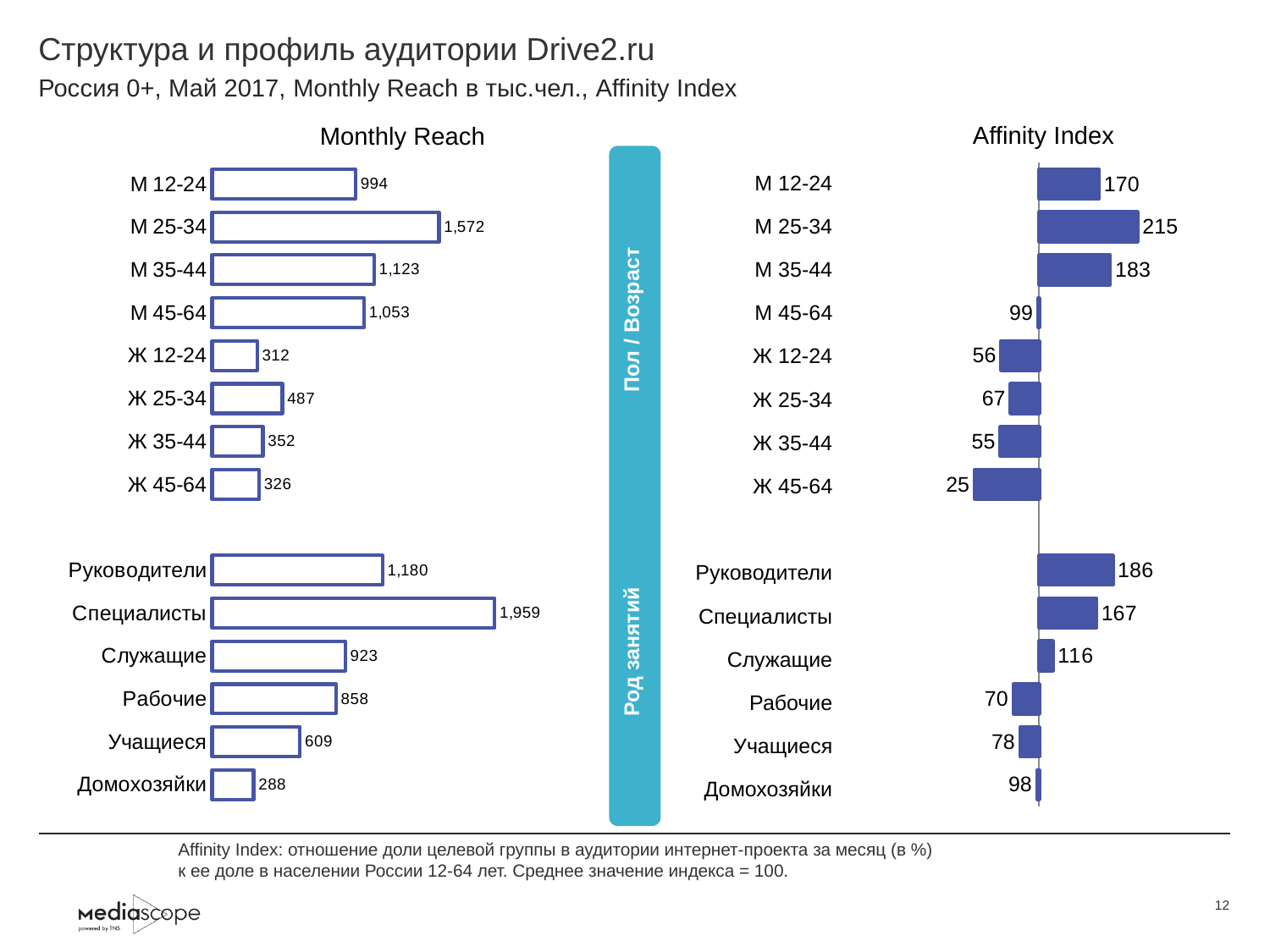
In the Affinity Index chart, what is the value for Ж 45-64? 25 In the Monthly Reach chart, what is the value for М 25-34? 1,572 In the Affinity Index chart, what is the difference between М 35-44 and М 45-64? 84 How many categories are shown in the Monthly Reach chart? 14 What kind of chart is the Affinity Index chart? Bar chart In the Affinity Index chart, which category has the highest value? М 25-34 In the Monthly Reach chart, which is larger: Ж 25-34 or Ж 35-44? Ж 25-34 In the Monthly Reach chart, which category has the highest value? Специалисты In the Affinity Index chart, which category has the lowest value? Ж 45-64 In the Affinity Index chart, which is larger: Рабочие or Учащиеся? Учащиеся In the Monthly Reach chart, which category has the lowest value? Домохозяйки In the Monthly Reach chart, what is the difference between Руководители and Служащие? 257